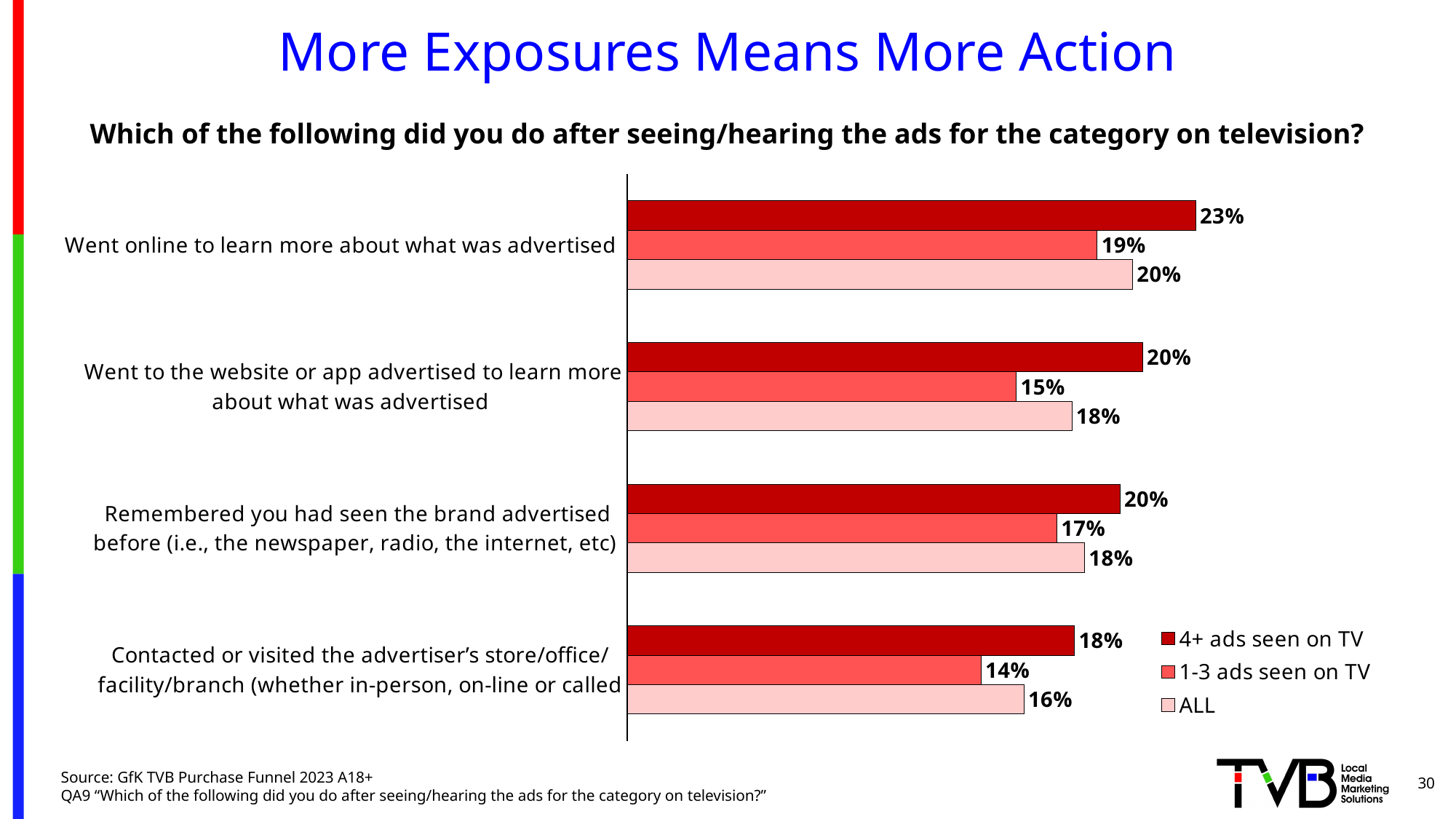
How many action categories are shown on the chart? 4 For 'Went online to learn more about what was advertised', which is larger: the 4+ ads seen on TV value or the ALL value? 4+ ads seen on TV What percentage of respondents who saw 4+ ads on TV went online to learn more about what was advertised? 23% What percentage of respondents who saw 1-3 ads on TV contacted or visited the advertiser's store/office/facility/branch? 14% Which action has the highest value for the 4+ ads seen on TV series? Went online to learn more about what was advertised How many series does the legend list? 3 What is the 1-3 ads seen on TV value for 'Remembered you had seen the brand advertised before'? 17% Which action has the lowest value for the 1-3 ads seen on TV series? Contacted or visited the advertiser's store/office/facility/branch Which series is shown in the darkest red colour in the legend? 4+ ads seen on TV What type of chart is shown on the slide? Bar chart What is the difference between the 4+ ads and 1-3 ads values for 'Went to the website or app advertised to learn more about what was advertised'? 5% What is the ALL value for 'Went to the website or app advertised to learn more about what was advertised'? 18%